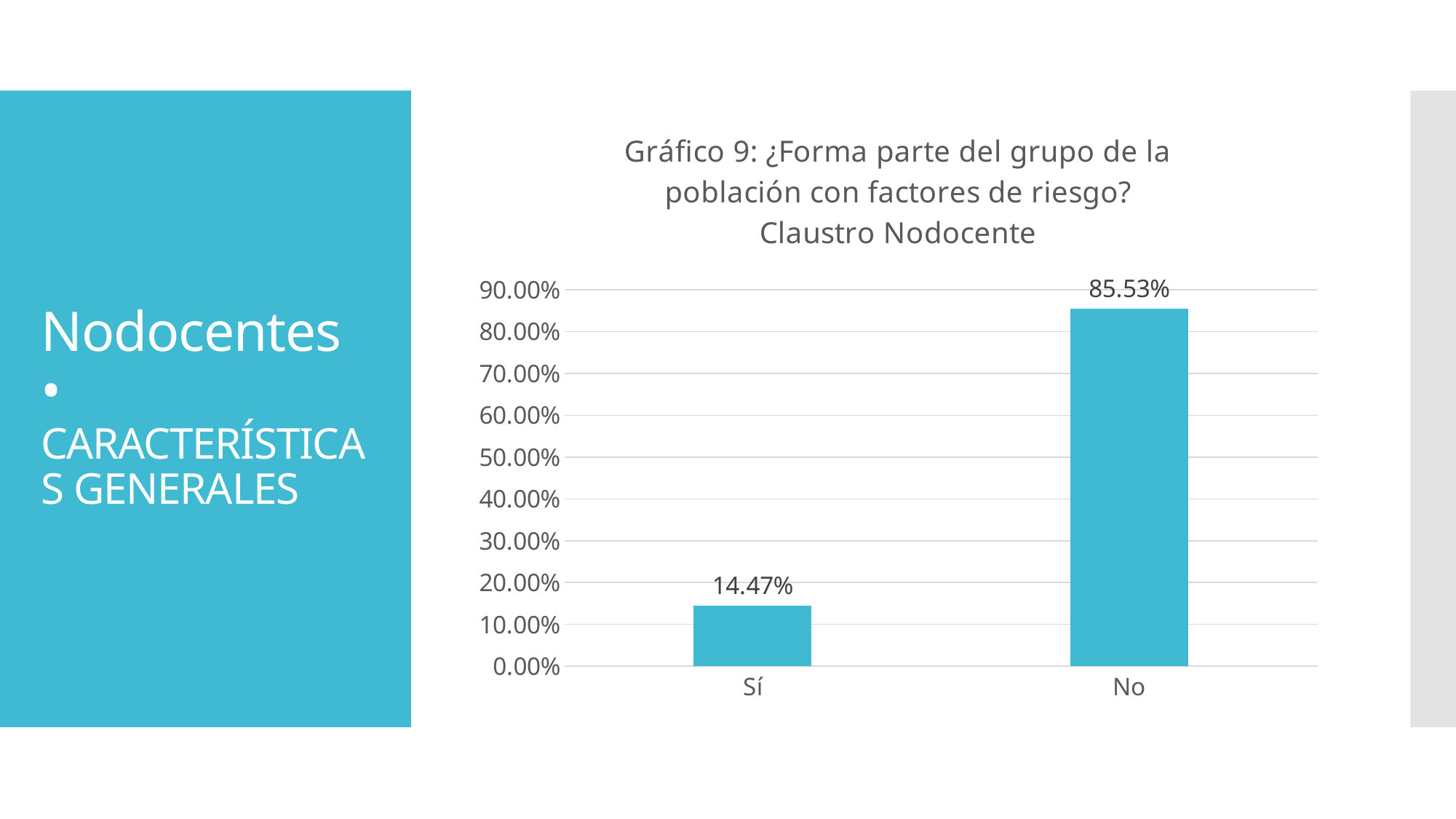
What kind of chart is shown on the slide? Bar chart Which category has the highest value? No What is the value for "No"? 85.53% What is the difference between the values for "No" and "Sí"? 71.06% Which category has the lowest value? Sí What is the highest value shown on the y axis? 90.00% How many categories are shown on the x axis? 2 What is the title of the chart? Gráfico 9: ¿Forma parte del grupo de la población con factores de riesgo? Claustro Nodocente Is the value for "Sí" greater or less than 20.00%? less Which is larger, the value for "Sí" or the value for "No"? No Is the value for "No" greater or less than 80.00%? greater What is the value for "Sí"? 14.47%